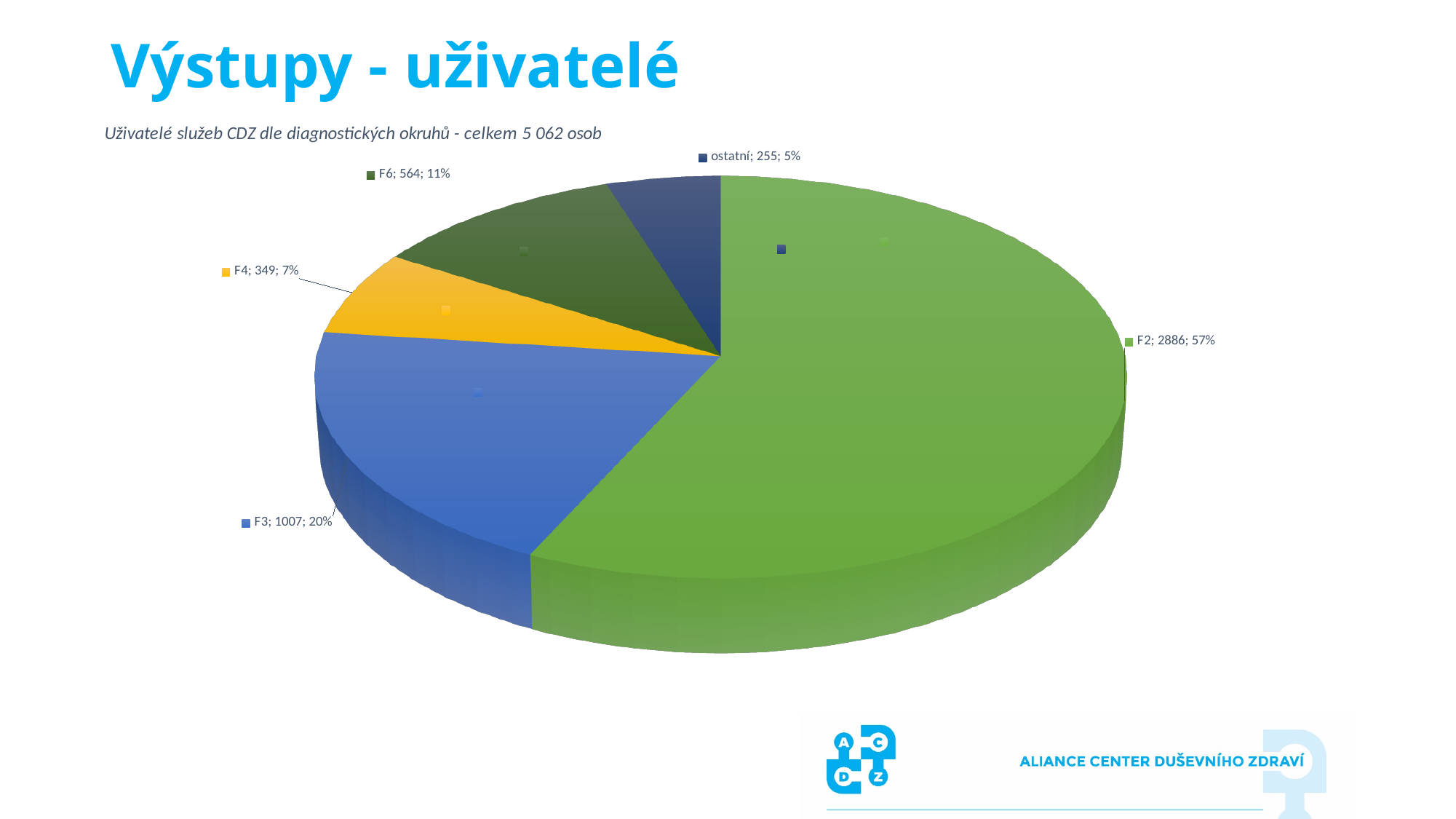
What is the value for F3? 1007 What is the value for F6? 564 What is the value for F2? 2886 What share of the pie does F2 represent? 57% What share of the pie does F4 represent? 7% What is the value for ostatní? 255 Which category has the smallest slice? ostatní What is the title of the chart? Uživatelé služeb CDZ dle diagnostických okruhů - celkem 5 062 osob What kind of chart is shown on the slide? pie chart How many slices does the pie chart have? 5 Which category has the largest slice? F2 What is the difference between the values for F3 and F6? 443